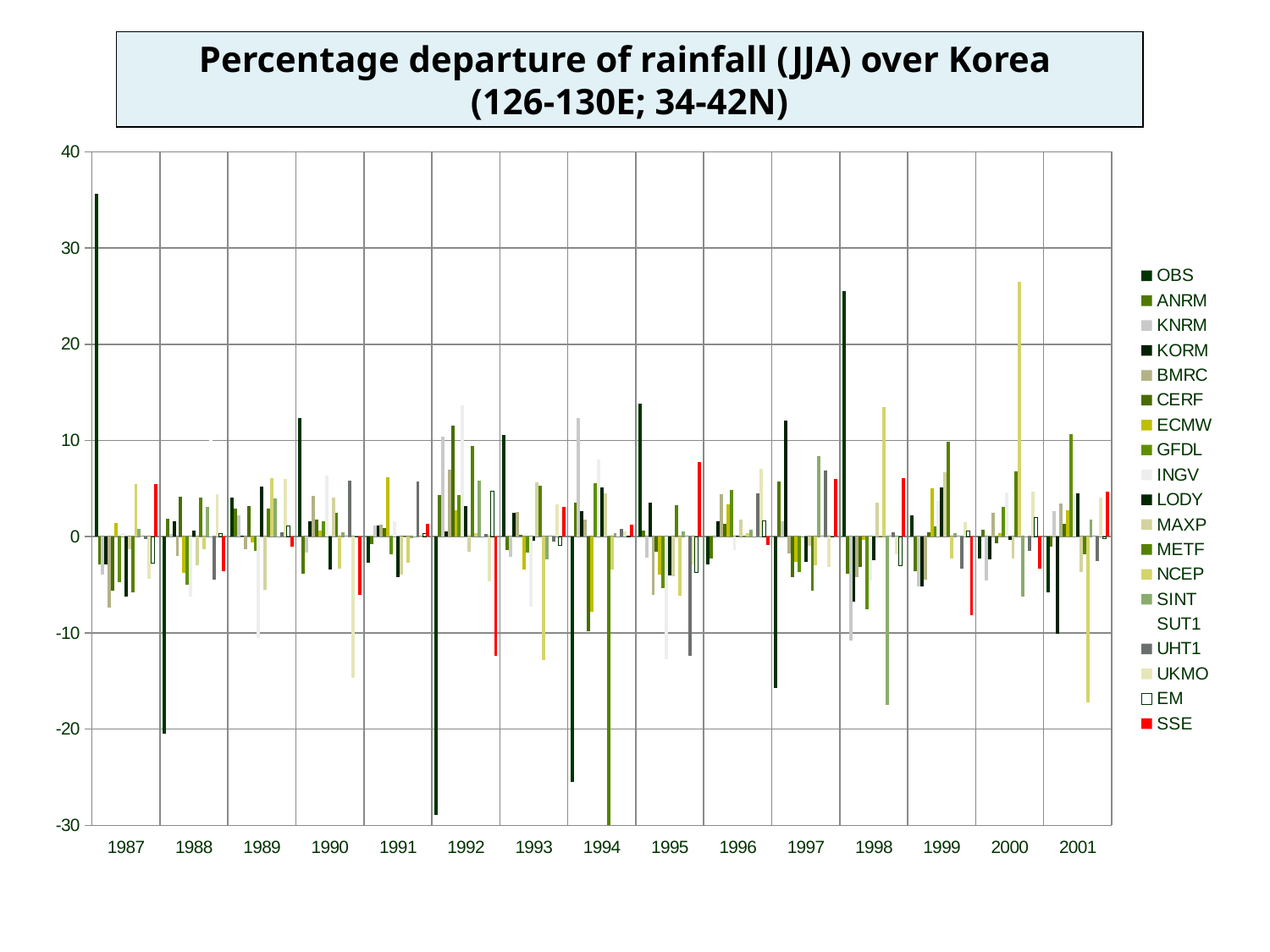
What kind of chart is shown on the slide? bar chart Which series is drawn in red in the legend? SSE Is the SSE value for 1992 greater or less than -10? less What is the title of the chart? Percentage departure of rainfall (JJA) over Korea (126-130E; 34-42N) How many series does the legend list? 19 Is the OBS value for 1994 greater or less than -20? less Is the OBS value for 1987 greater or less than 30? greater How many years are shown along the x axis? 15